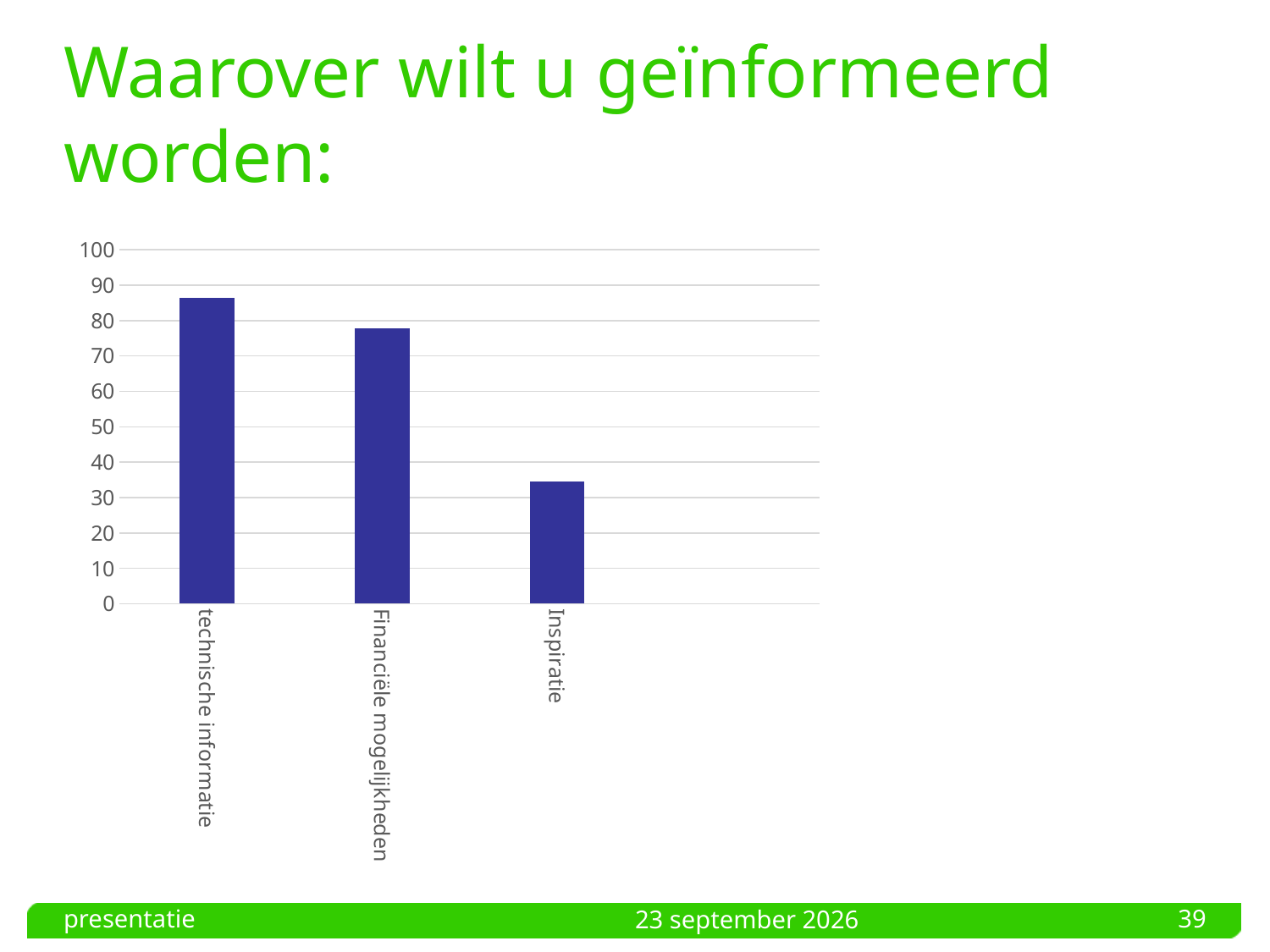
Which is larger, the value for technische informatie or the value for Inspiratie? technische informatie What is the maximum value shown on the vertical axis? 100 Is the value for Inspiratie greater or less than 40? less Which category has the highest bar? technische informatie Which category has the lowest bar? Inspiratie Is the value for technische informatie greater or less than 80? greater How many categories are plotted in the chart? 3 What kind of chart is shown on the slide? bar chart Is the value for Financiële mogelijkheden greater or less than 70? greater Which is larger, the value for Financiële mogelijkheden or the value for Inspiratie? Financiële mogelijkheden Do the bar values rise or fall from left to right along the x axis? fall